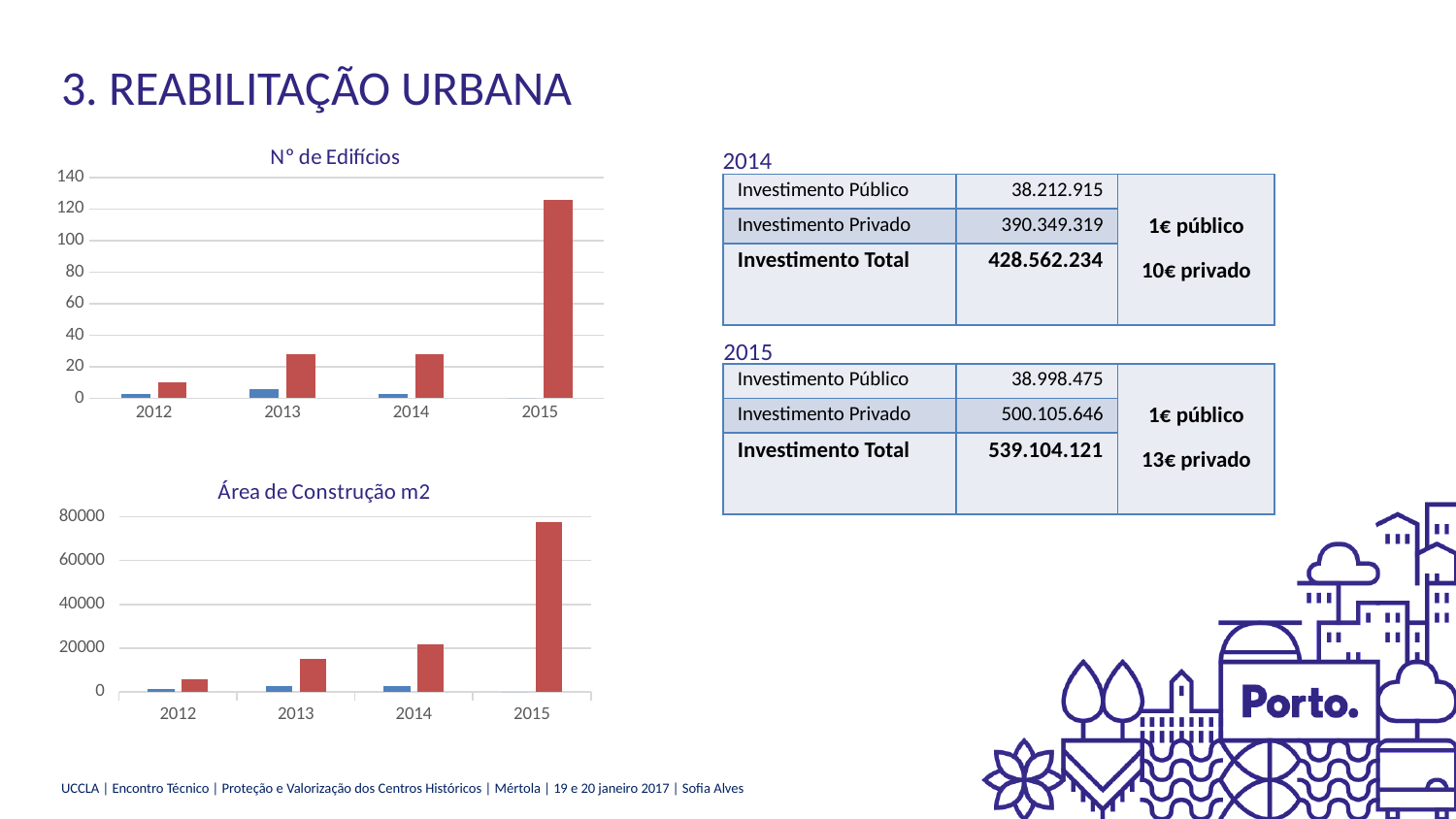
In the "Área de Construção m2" chart, is the red bar for 2013 greater or less than 20000? less What kind of chart is the "N° de Edifícios" chart? bar chart In the "N° de Edifícios" chart, is the red bar for 2012 greater or less than 20? less In the "Área de Construção m2" chart, is the red bar for 2015 greater or less than 60000? greater In the "Área de Construção m2" chart, which year has the tallest red bar? 2015 How many years are shown on the x axis of the "N° de Edifícios" chart? 4 In the "Área de Construção m2" chart, which red bar is taller, 2014 or 2015? 2015 How many years are shown on the x axis of the "Área de Construção m2" chart? 4 In the "N° de Edifícios" chart, which year has the tallest red bar? 2015 What kind of chart is the "Área de Construção m2" chart? bar chart What is the title of the upper chart on the slide? N° de Edifícios